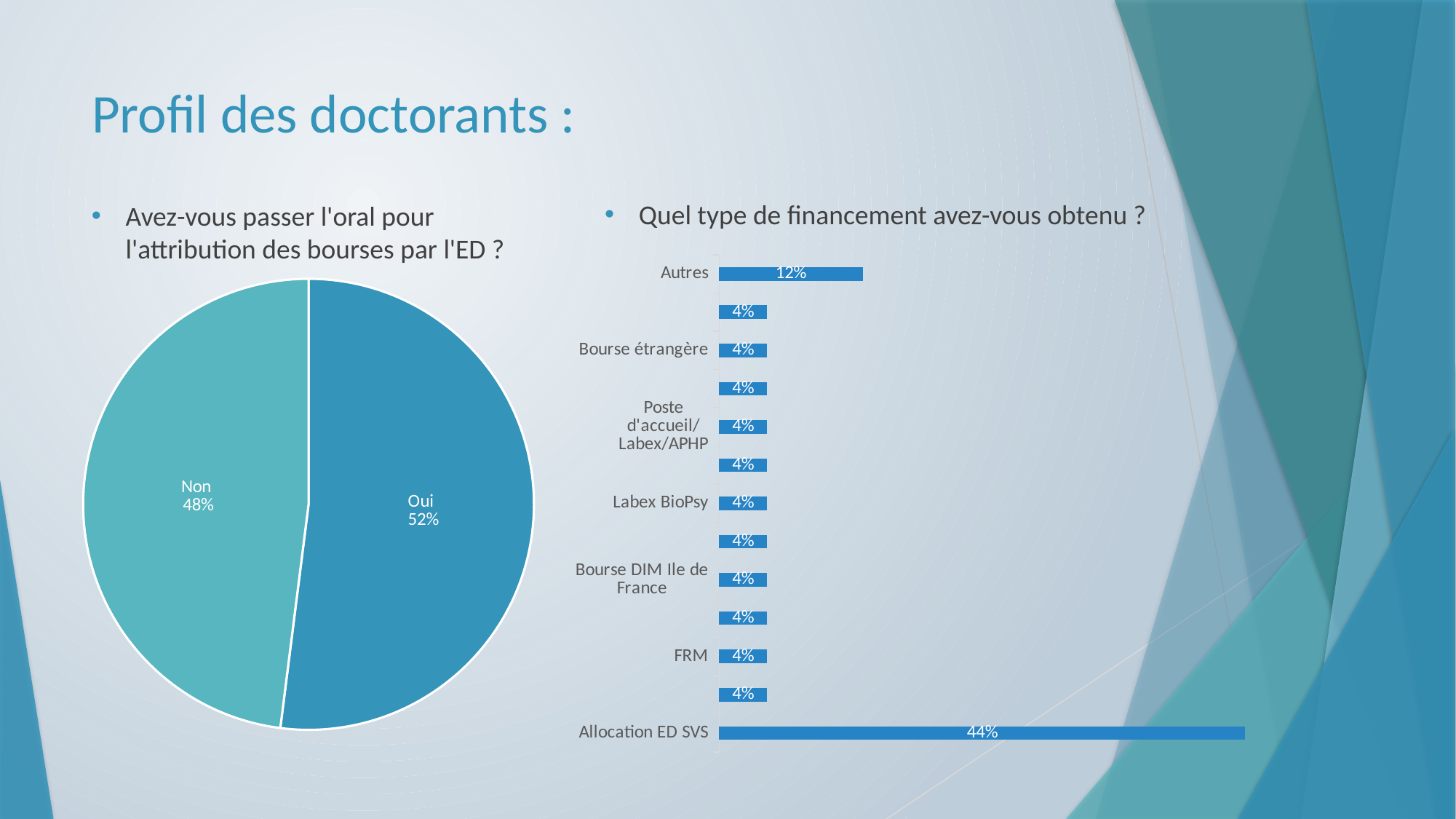
What kind of chart is shown on the left of the slide? Pie chart In the bar chart on the right, what is the difference between Allocation ED SVS and Autres? 32% In the bar chart on the right, what is the value for Allocation ED SVS? 44% In the bar chart on the right, what is the value for Autres? 12% In the bar chart on the right, how many bars are plotted? 13 In the pie chart on the left, what percentage answered "Non"? 48% What kind of chart is shown on the right of the slide, under "Quel type de financement avez-vous obtenu ?"? Bar chart In the pie chart on the left, what percentage answered "Oui"? 52% In the bar chart on the right, which category has the highest value? Allocation ED SVS In the pie chart on the left, what is the difference between the Oui and Non shares? 4% In the bar chart on the right, what is the value for FRM? 4% In the pie chart on the left, which slice is larger, Oui or Non? Oui